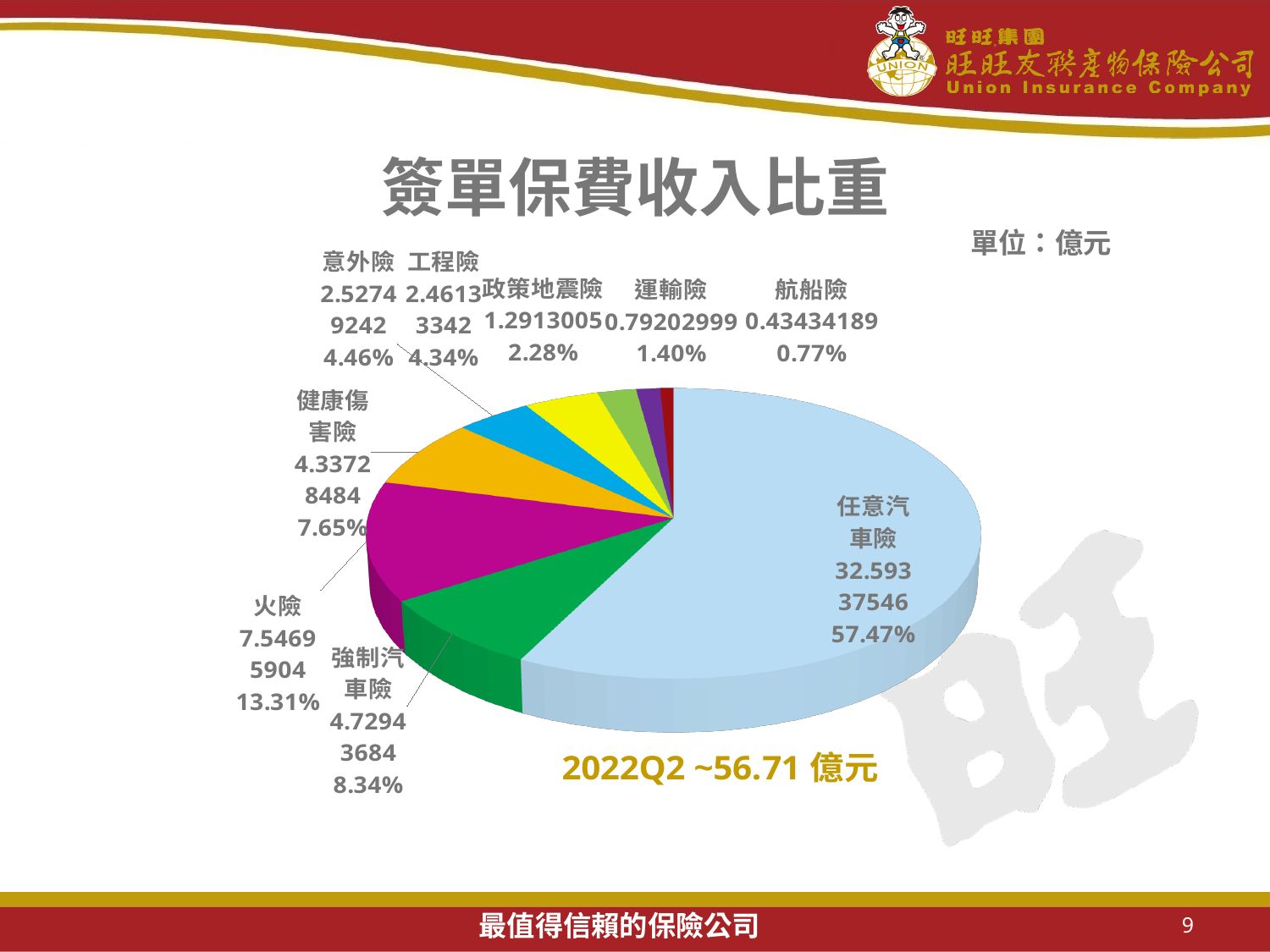
What is the title of the chart? 簽單保費收入比重 What share of the pie does 火險 account for? 13.31% What percentage is shown for 強制汽車險? 8.34% What percentage is shown for 航船險? 0.77% What type of chart is shown on the slide? pie chart What is the difference in percentage points between the shares of 任意汽車險 and 火險? 44.16% Which category has the largest share of the pie? 任意汽車險 Which has a larger share, 健康傷害險 or 強制汽車險? 強制汽車險 Which category has the smallest share of the pie? 航船險 What unit is stated for the chart values? 億元 How many categories (slices) does the pie chart have? 9 What share of the pie does 任意汽車險 account for? 57.47%